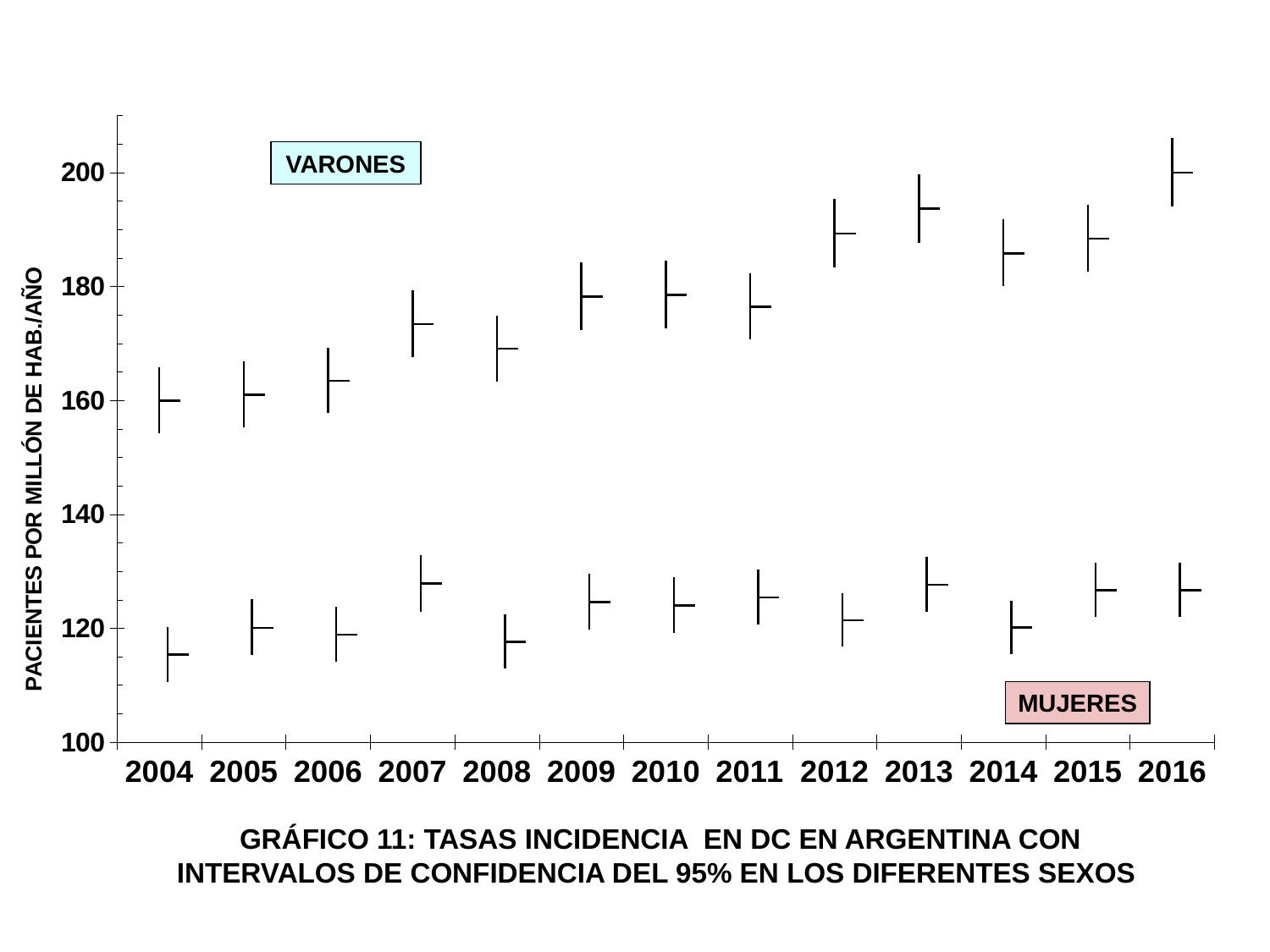
How many years are shown on the x axis? 13 Is the VARONES value for 2012 greater or less than 180? greater Is the VARONES value for 2013 greater or less than 200? less What kind of chart is shown on the slide? A scatter chart with error bars (confidence intervals) Do the VARONES values generally rise or fall from 2004 to 2016? rise In 2010, which group has the larger value, VARONES or MUJERES? VARONES How many series (groups) are plotted on the chart? 2 Which year has the highest value for VARONES? 2016 What is the label of the y axis? PACIENTES POR MILLÓN DE HAB./AÑO Is the MUJERES value for 2007 greater or less than 120? greater